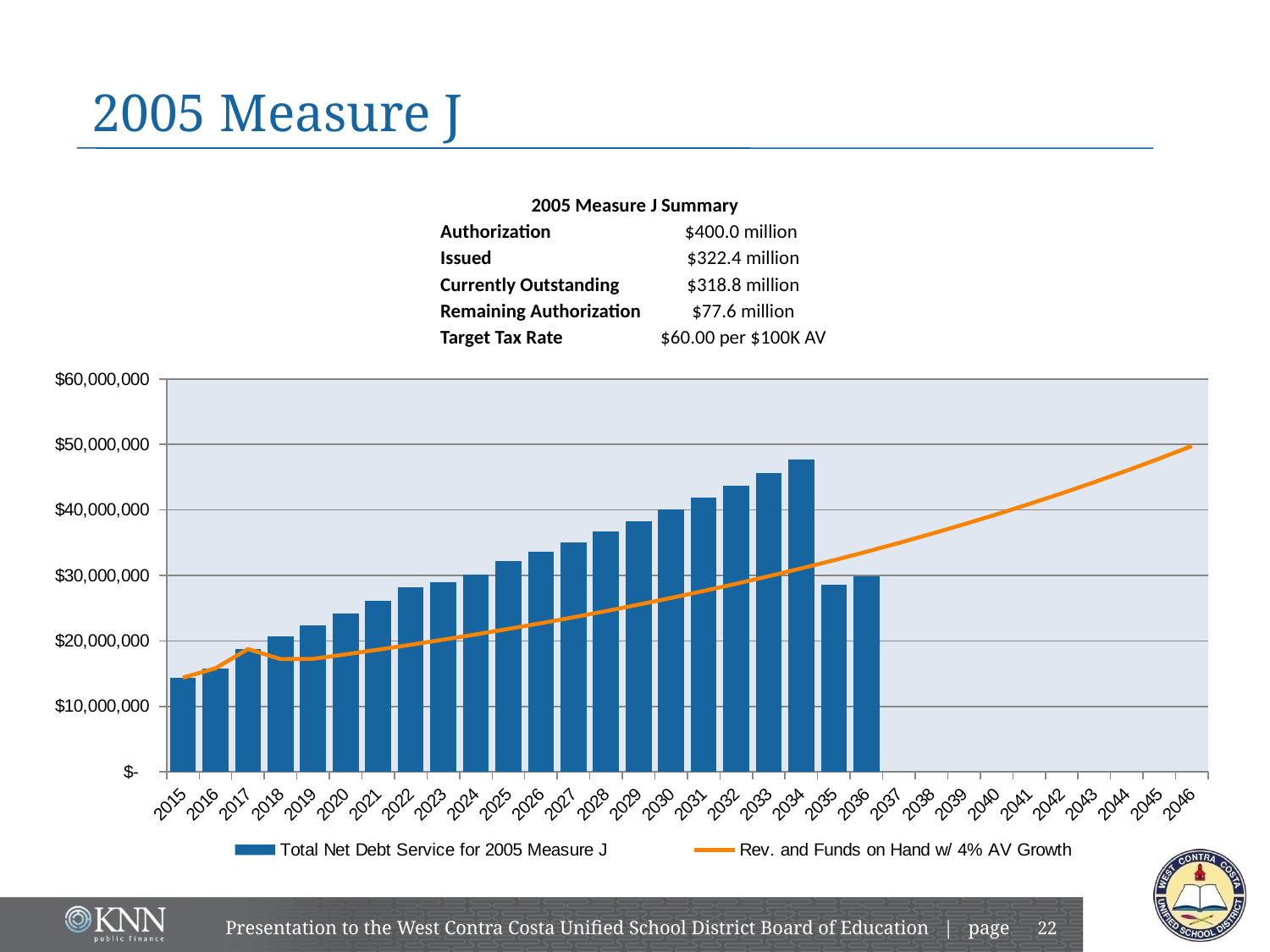
How many series does the chart legend list? 2 Which year has the shortest bar for Total Net Debt Service for 2005 Measure J? 2015 Is the Total Net Debt Service bar for 2015 greater or less than $10,000,000? greater Is the Total Net Debt Service bar for 2028 greater or less than $30,000,000? greater What kind of chart is shown on the slide? A combined bar and line chart Does the Rev. and Funds on Hand w/ 4% AV Growth line generally rise or fall from 2019 to 2046? rise What colour are the Total Net Debt Service for 2005 Measure J bars? Blue Is the Rev. and Funds on Hand line value for 2046 greater or less than $40,000,000? greater Which year has the tallest bar for Total Net Debt Service for 2005 Measure J? 2034 Which is larger, the Total Net Debt Service bar for 2034 or for 2035? 2034 How many years are labelled on the x axis of the chart? 32